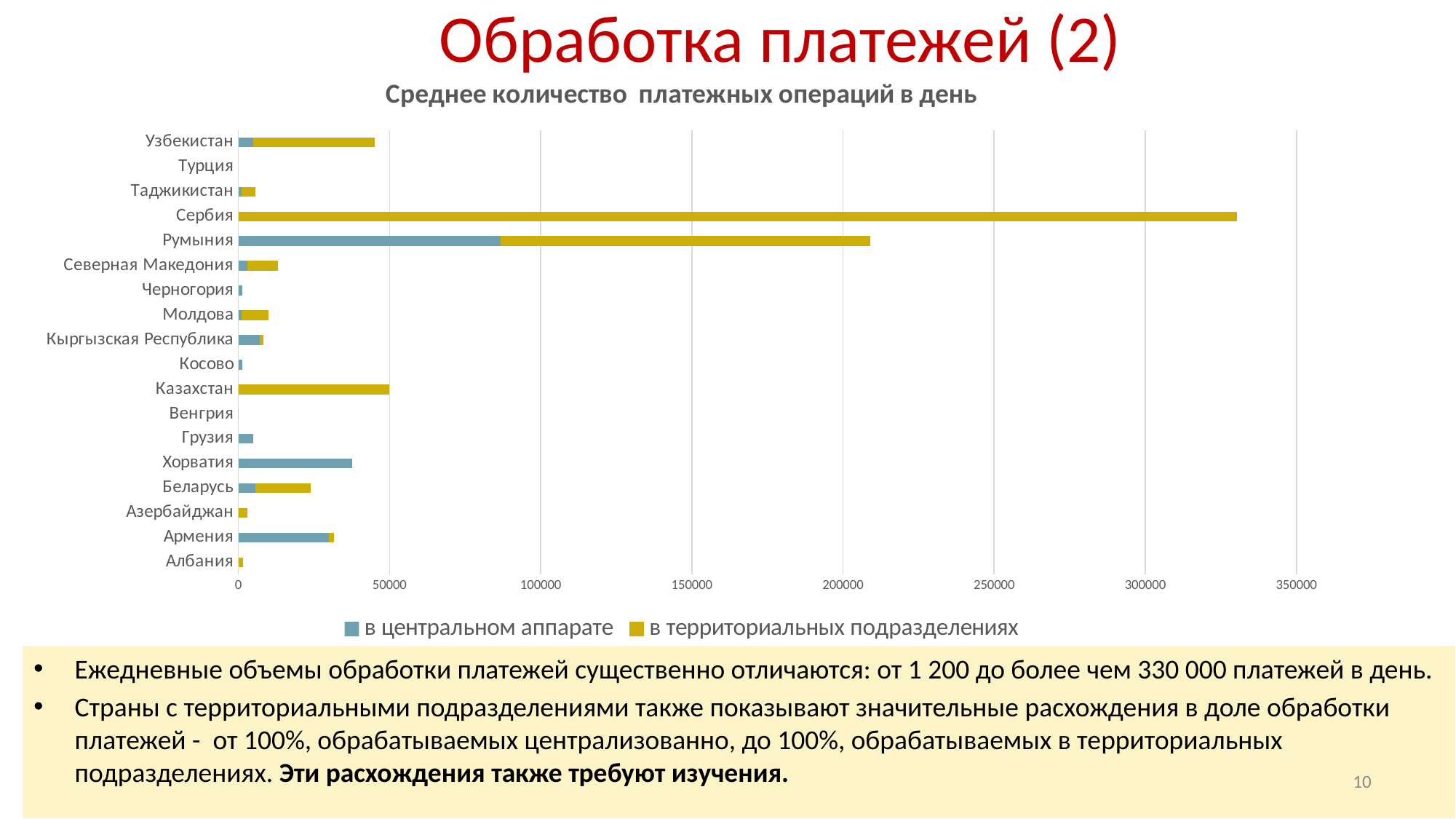
Is the total value for Узбекистан greater or less than 100000? less Which has a larger total value, Сербия or Румыния? Сербия Which has a larger total value, Хорватия or Грузия? Хорватия Which country has the highest total average number of payment operations per day? Сербия Is the total value for Сербия greater or less than 300000? greater For Румыния, which series has the larger value: 'в центральном аппарате' or 'в территориальных подразделениях'? в территориальных подразделениях What is the title of the chart? Среднее количество платежных операций в день Is the total value for Румыния greater or less than 150000? greater How many countries are listed on the vertical axis of the chart? 18 How many series does the legend list? 2 What kind of chart is shown on the slide? Bar chart